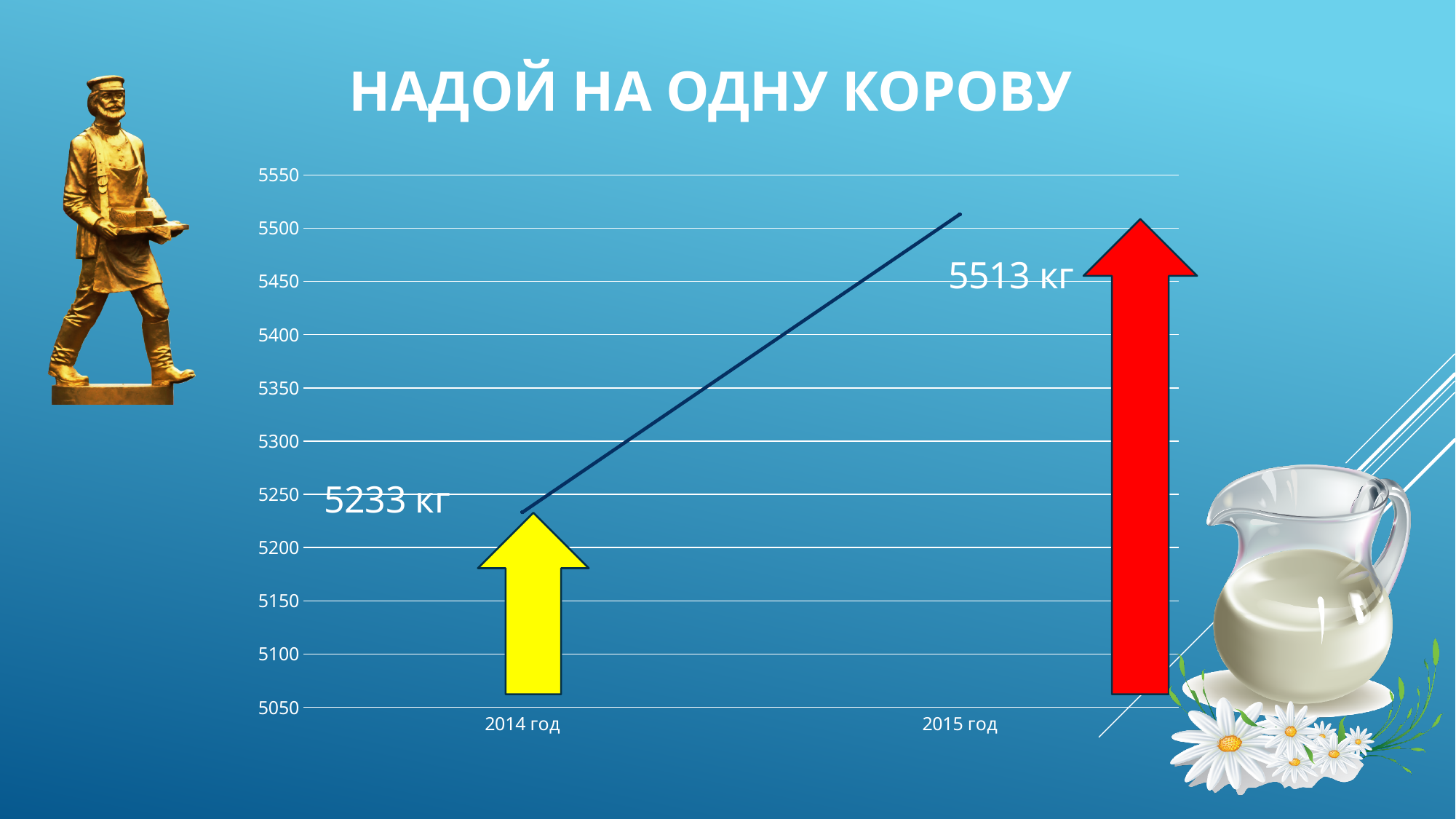
What kind of chart is shown on the slide? line chart What is the title of the chart? НАДОЙ НА ОДНУ КОРОВУ Is the value for 2014 год greater or less than 5300? less How many years are plotted on the chart? 2 Which year has the higher value? 2015 год What is the difference between the values for 2015 год and 2014 год? 280 кг Is the value for 2015 год larger or smaller than the value for 2014 год? larger Does the value rise or fall from 2014 год to 2015 год? rise Which year has the lower value? 2014 год What is the value for 2014 год? 5233 кг What is the value for 2015 год? 5513 кг Is the value for 2015 год greater or less than 5400? greater